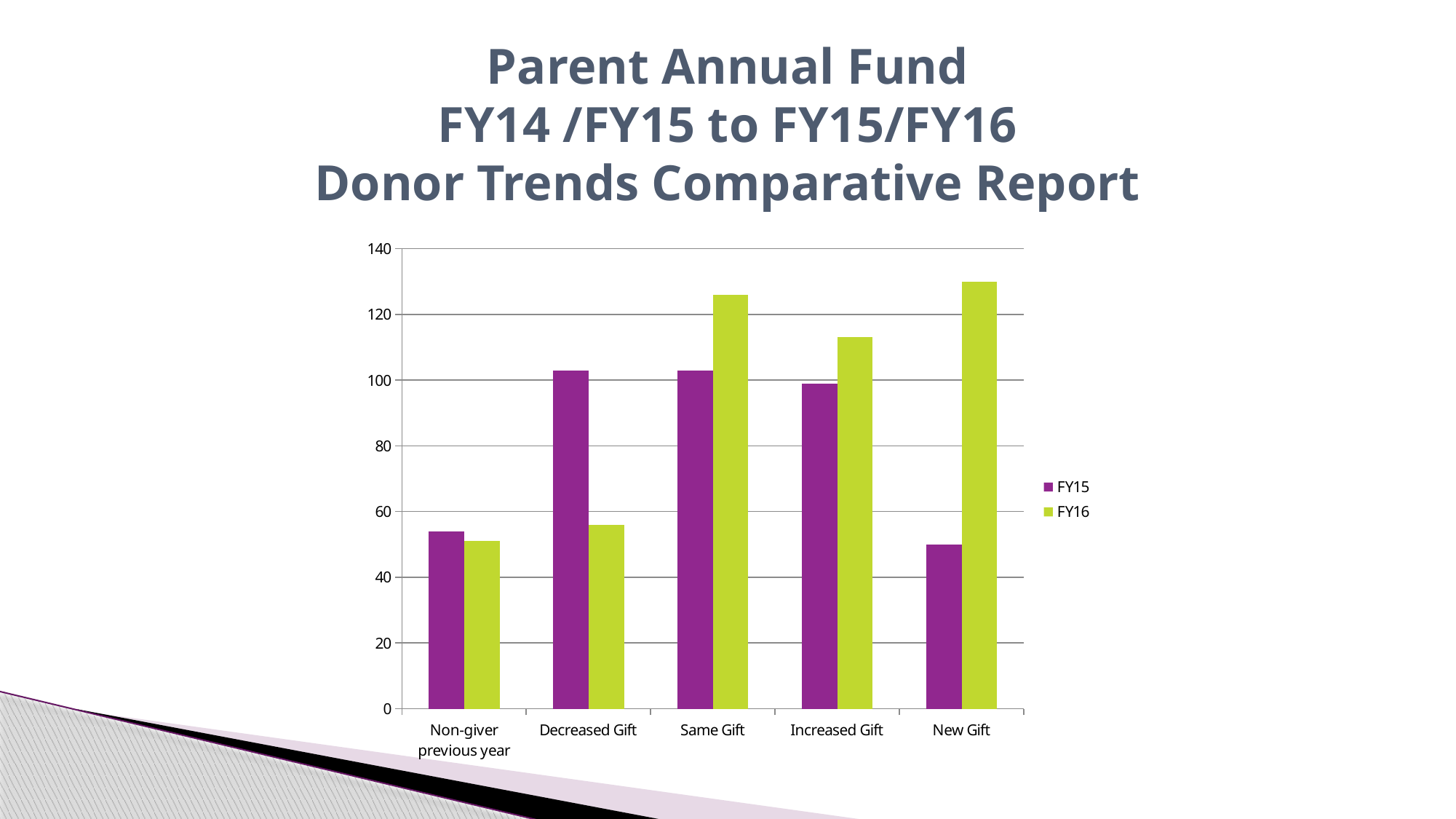
Which series is shown in green in the legend? FY16 How many series does the legend list? 2 Is the FY16 value for New Gift greater or less than 120? greater What kind of chart is shown on the slide? bar chart For New Gift, which is larger, FY15 or FY16? FY16 For Increased Gift, which is larger, FY15 or FY16? FY16 Is the FY16 value for Decreased Gift greater or less than 80? less For Decreased Gift, which is larger, FY15 or FY16? FY15 Is the FY15 value for Non-giver previous year greater or less than 60? less How many categories are shown on the x axis? 5